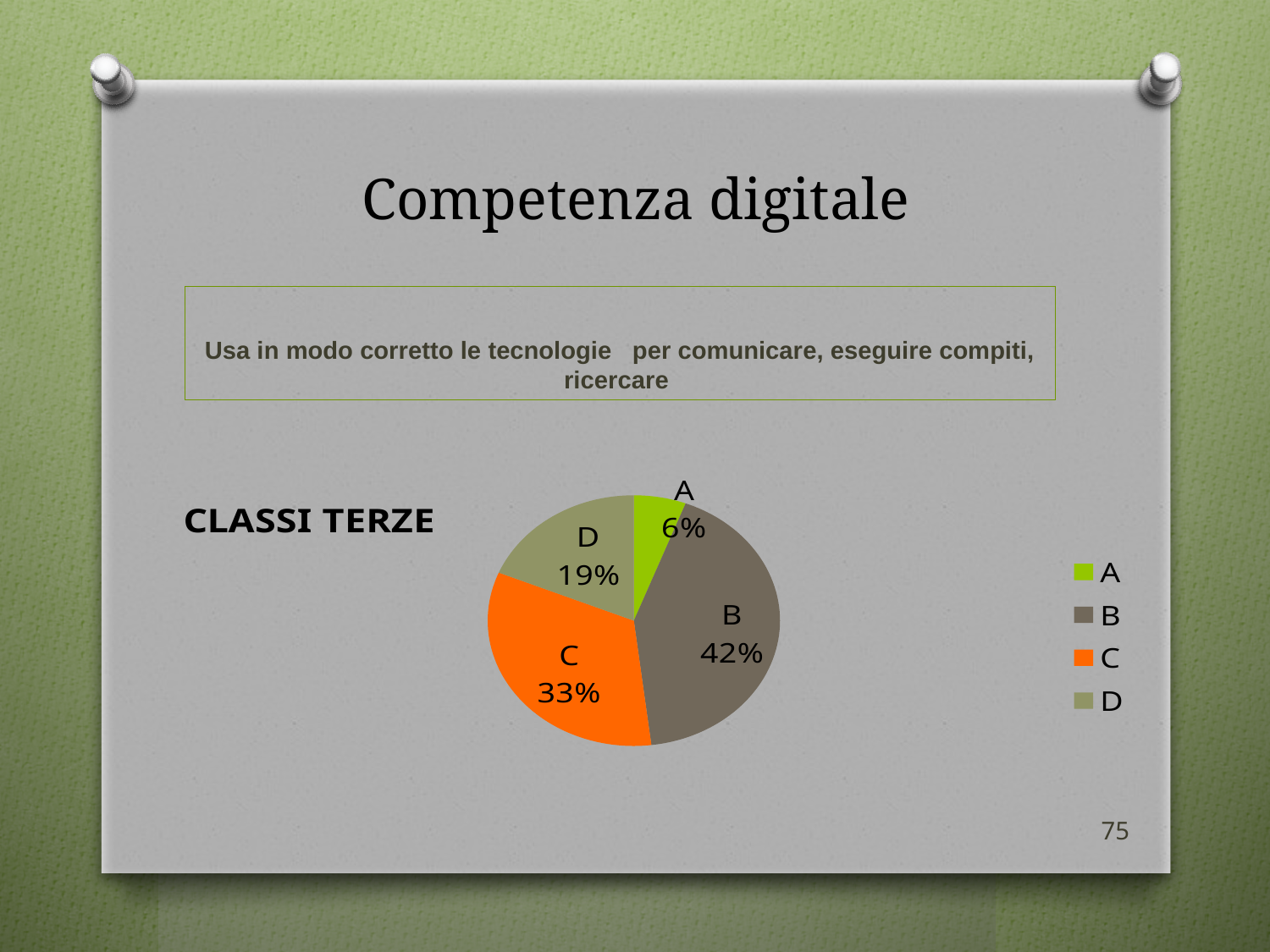
How many slices does the pie chart have? 4 What percentage does slice B represent in the pie chart? 42% Which category has the smallest slice of the pie chart? A What kind of chart is shown on the slide? pie chart What colour is slice C in the pie chart? orange Which category has the largest slice of the pie chart? B What percentage does slice A represent in the pie chart? 6% What is the difference in percentage points between slice B and slice C? 9 What percentage does slice C represent in the pie chart? 33% How many entries does the legend list? 4 Which is larger, slice C or slice D? C What percentage does slice D represent in the pie chart? 19%